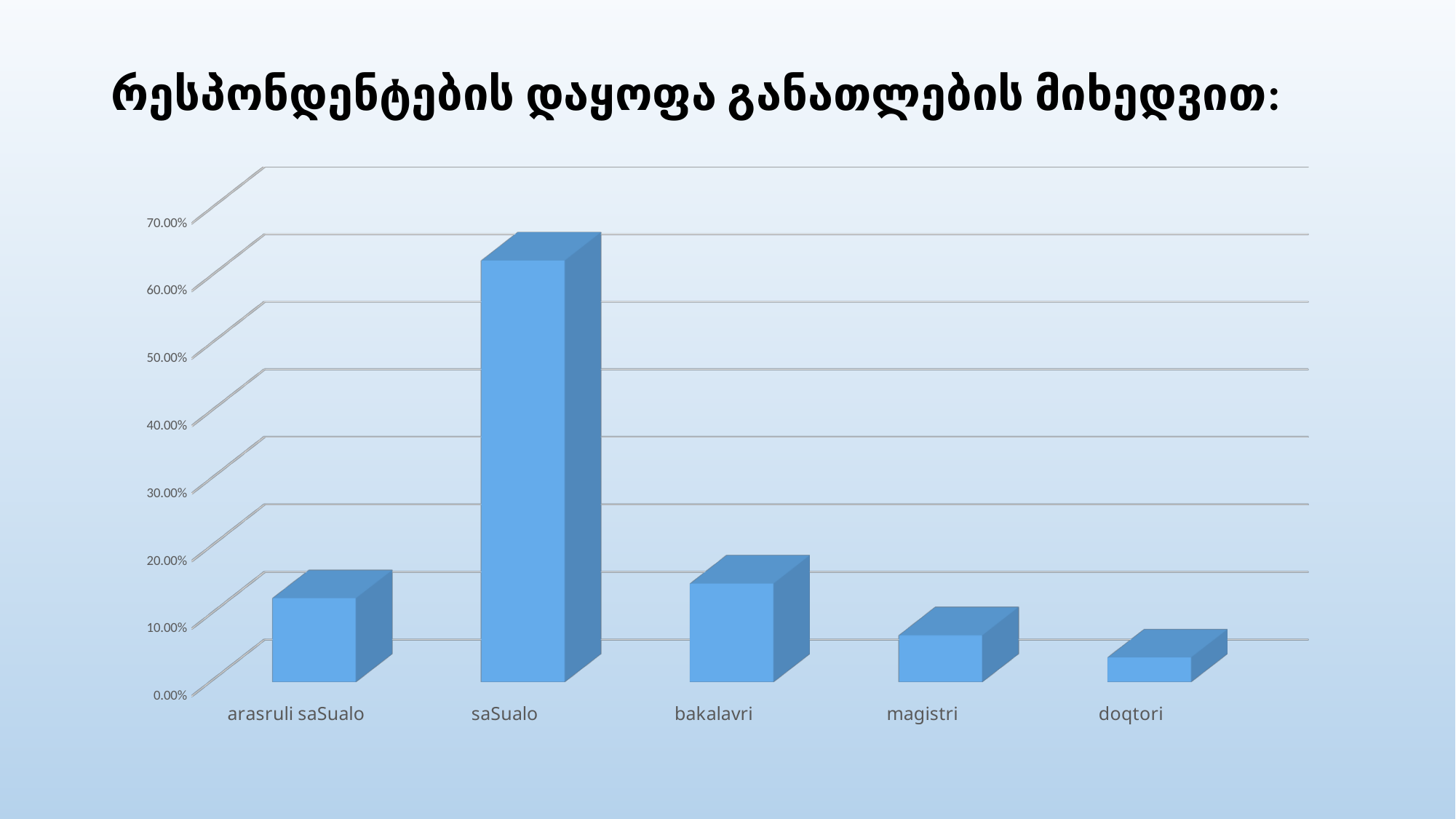
Is the value for arasruli saSualo greater or less than 10.00%? greater Which is larger, the value for saSualo or the value for bakalavri? saSualo What kind of chart is shown on the slide? bar chart Is the value for saSualo greater or less than 50.00%? greater Which category has the highest value in the chart? saSualo What is the label of the second category from the left on the x axis? saSualo Which is larger, the value for magistri or the value for doqtori? magistri Is the value for doqtori greater or less than 10.00%? less Which is larger, the value for bakalavri or the value for doqtori? bakalavri Which category has the lowest value in the chart? doqtori How many categories are shown on the x axis of the chart? 5